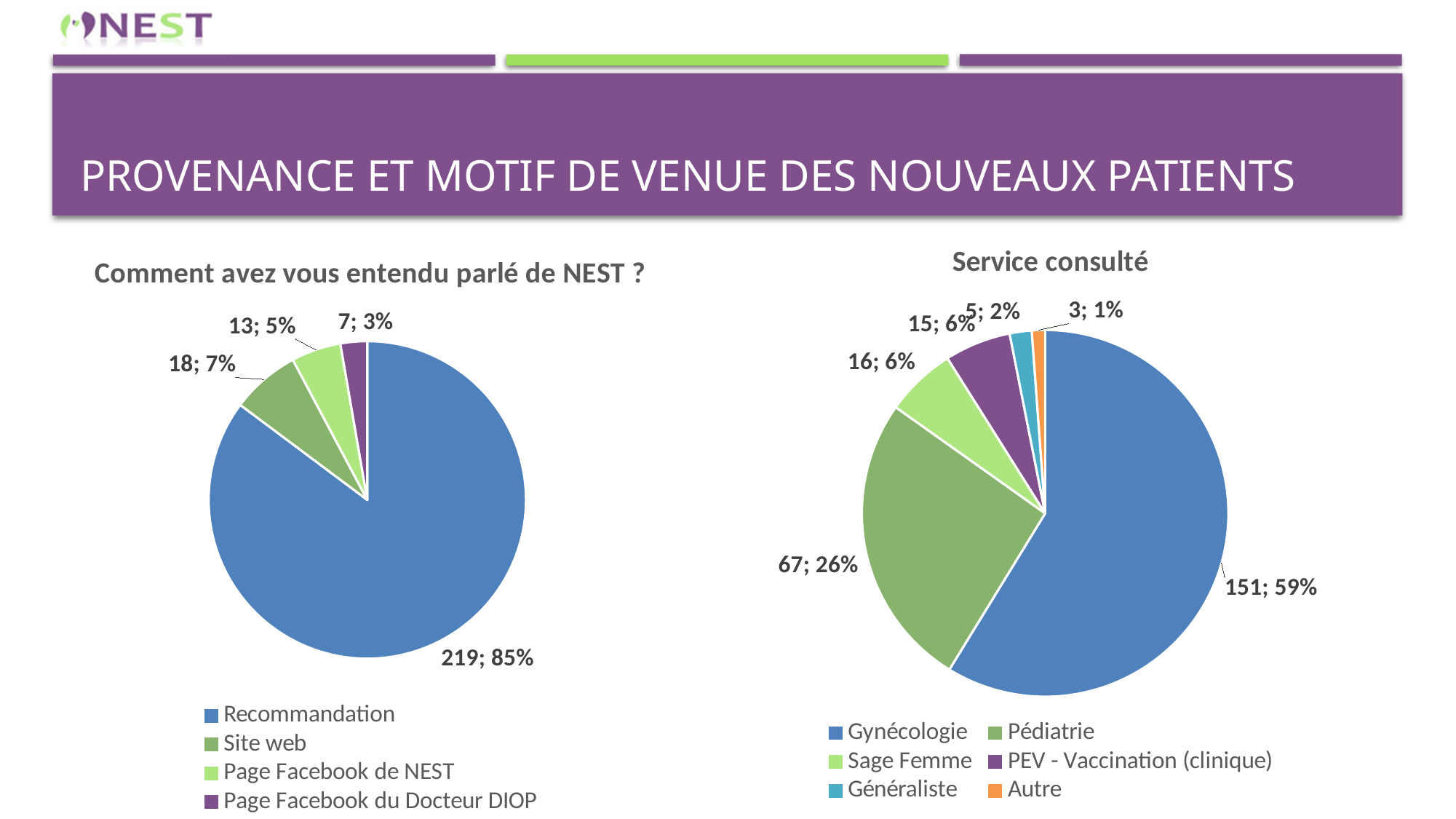
In the 'Service consulté' pie chart, which has the larger count, Généraliste or Autre? Généraliste In the 'Service consulté' pie chart, which service has the lowest count? Autre In the 'Comment avez vous entendu parlé de NEST ?' pie chart, what is the data label for Recommandation? 219; 85% In the 'Comment avez vous entendu parlé de NEST ?' pie chart, which category is the smallest? Page Facebook du Docteur DIOP In the 'Service consulté' pie chart, how many patients consulted Pédiatrie? 67 In the 'Comment avez vous entendu parlé de NEST ?' pie chart, how many patients heard of NEST via the Site web? 18 In the 'Service consulté' pie chart, what share of the pie is Sage Femme? 6% In the 'Comment avez vous entendu parlé de NEST ?' pie chart, what share of the pie is Page Facebook du Docteur DIOP? 3% What type of chart is used for 'Service consulté'? Pie chart In the 'Service consulté' pie chart, what is the difference in count between Gynécologie and Pédiatrie? 84 In the 'Comment avez vous entendu parlé de NEST ?' pie chart, how many categories does the legend list? 4 In the 'Service consulté' pie chart, what is the data label for Gynécologie? 151; 59%